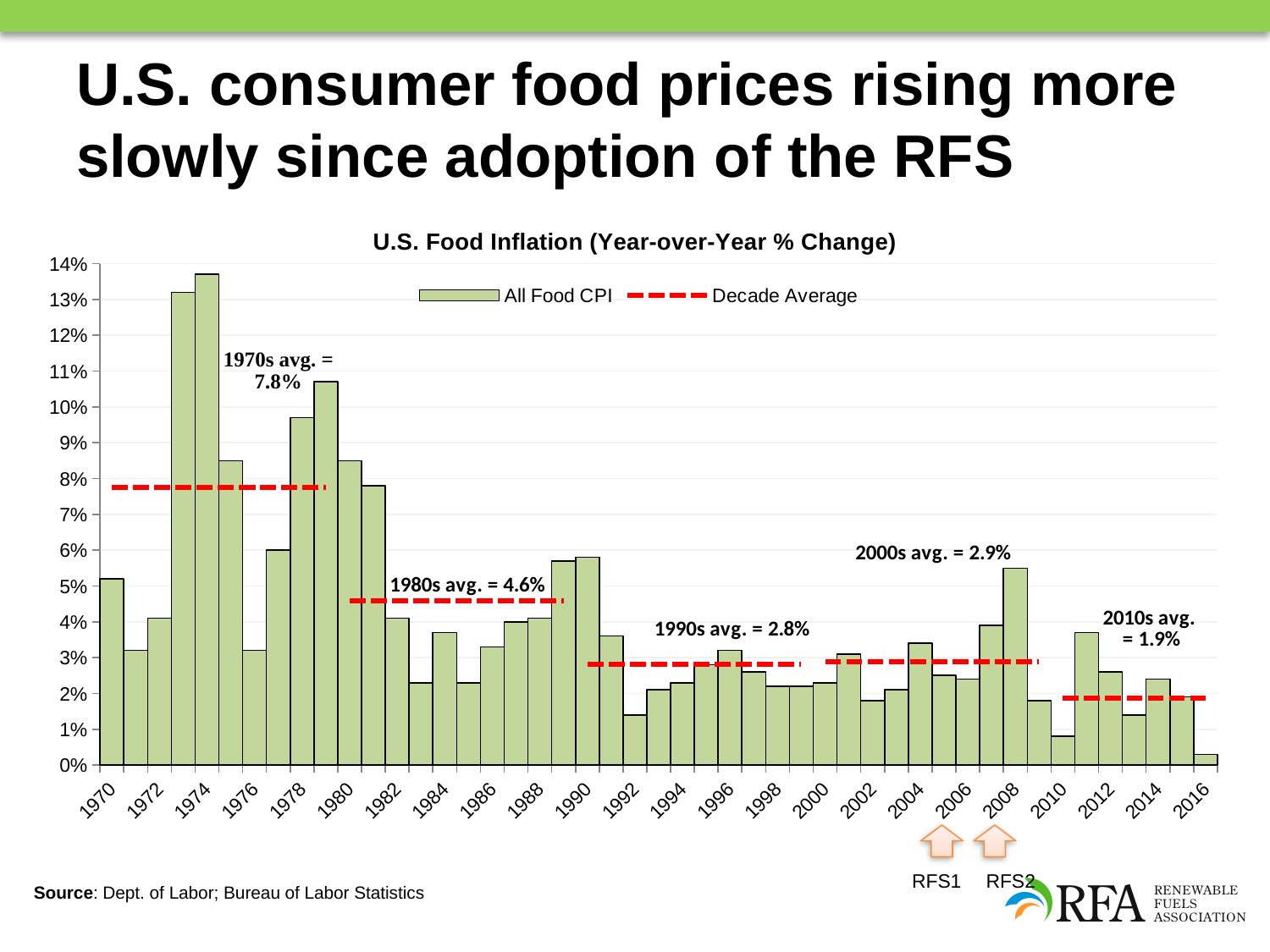
Is the value for 2016 greater or less than 1%? less What is the difference between the 1970s average and the 2010s average food inflation? 5.9 percentage points Which decade has the highest average food inflation shown on the chart? 1970s What kind of chart is shown on the slide? bar chart Which is larger, the 1990s average or the 2000s average food inflation? 2000s average How many series does the chart legend list? 2 Is the value for 1974 greater or less than 13%? greater What is the 1970s average food inflation shown on the chart? 7.8% What is the 1980s average food inflation shown on the chart? 4.6% What is the title of the chart? U.S. Food Inflation (Year-over-Year % Change) Which decade has the lowest average food inflation shown on the chart? 2010s What is the 2010s average food inflation shown on the chart? 1.9%